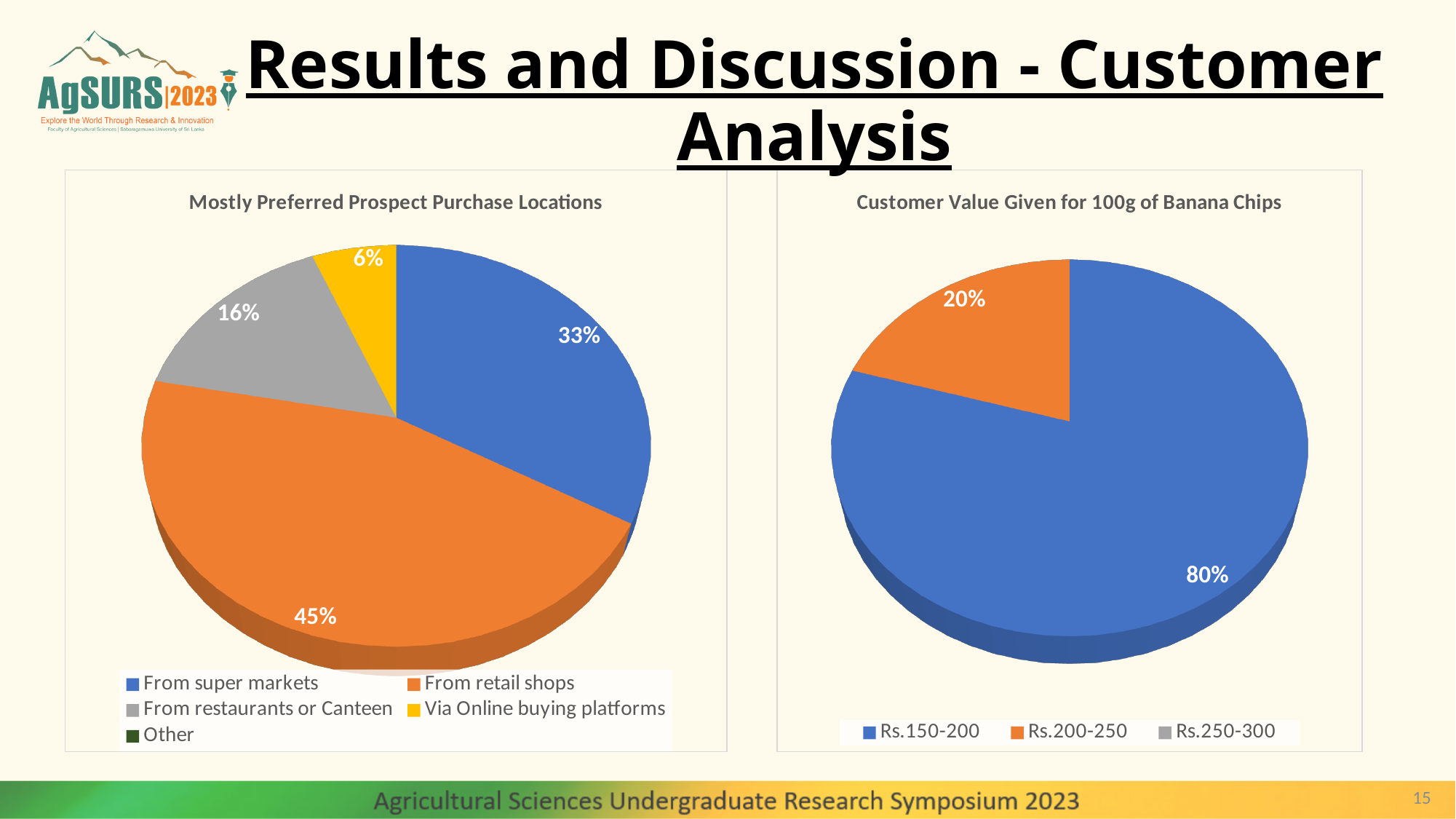
In the 'Mostly Preferred Prospect Purchase Locations' chart, what is the difference between the shares for 'From retail shops' and 'From super markets'? 12% In the 'Customer Value Given for 100g of Banana Chips' chart, what is the difference between the shares for 'Rs.150-200' and 'Rs.200-250'? 60% In the 'Customer Value Given for 100g of Banana Chips' chart, which price range has the largest slice? Rs.150-200 In the 'Mostly Preferred Prospect Purchase Locations' chart, what share is labelled for 'Via Online buying platforms'? 6% In the 'Customer Value Given for 100g of Banana Chips' chart, what share is labelled for 'Rs.150-200'? 80% What kind of chart is the 'Customer Value Given for 100g of Banana Chips' chart? Pie chart In the 'Mostly Preferred Prospect Purchase Locations' chart, how many entries does the legend list? 5 In the 'Mostly Preferred Prospect Purchase Locations' chart, what share is labelled for 'From restaurants or Canteen'? 16% In the 'Mostly Preferred Prospect Purchase Locations' chart, what share is labelled for 'From retail shops'? 45% In the 'Mostly Preferred Prospect Purchase Locations' chart, what share is labelled for 'From super markets'? 33% In the 'Customer Value Given for 100g of Banana Chips' chart, what share is labelled for 'Rs.200-250'? 20% In the 'Mostly Preferred Prospect Purchase Locations' chart, which purchase location has the largest slice? From retail shops